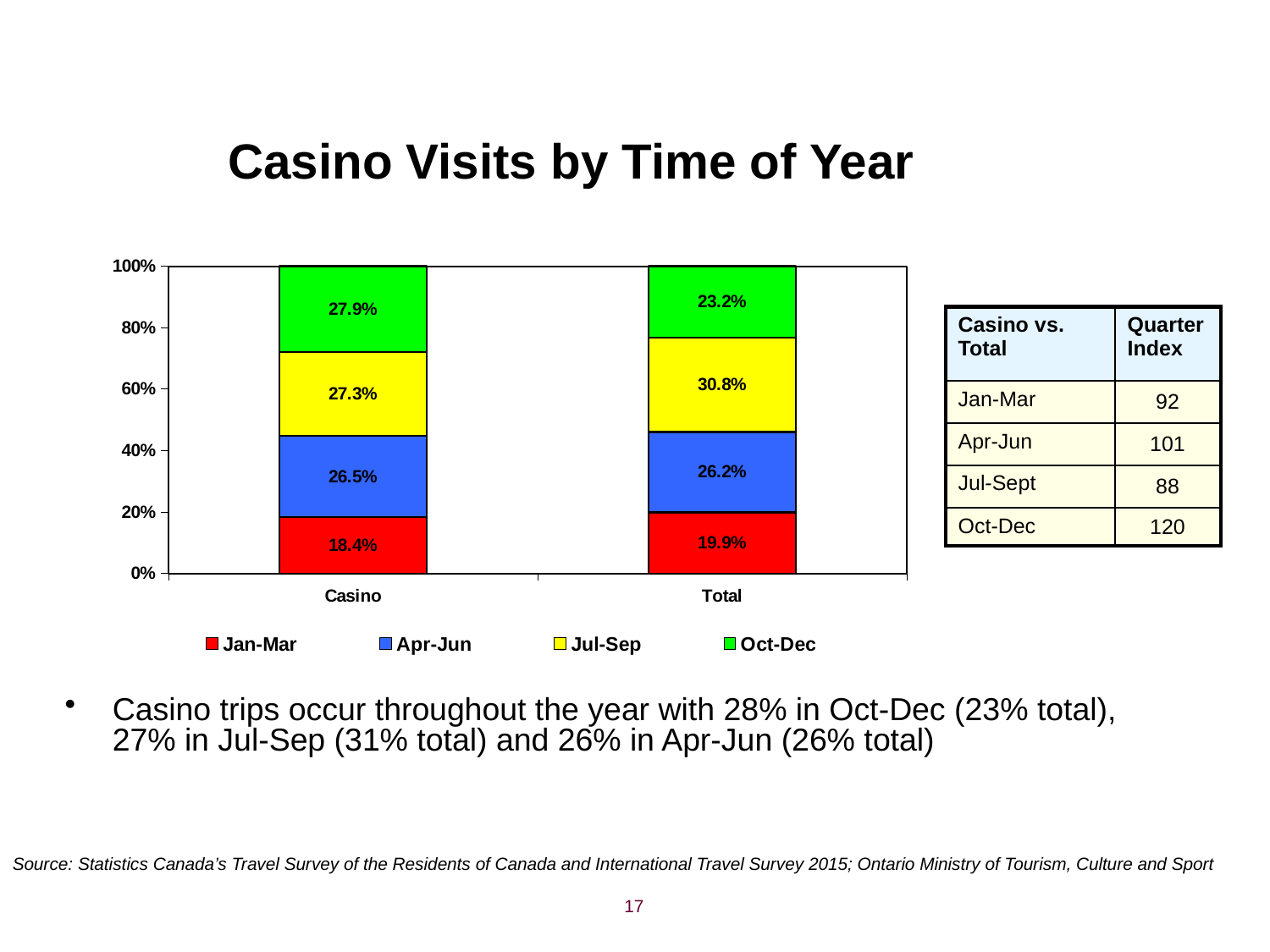
What kind of chart is shown on the slide? Stacked bar chart How many categories are shown on the x axis? 2 Which is larger, the Jul-Sep value for Casino or for Total? Total How many series does the legend list? 4 Which quarter has the largest share in the Casino bar? Oct-Dec What is the difference between the Oct-Dec values for Casino and Total? 4.7% What is the Oct-Dec value for the Casino bar? 27.9% What is the Apr-Jun value for the Total bar? 26.2% What is the Jul-Sep value for the Total bar? 30.8% What is the Jan-Mar value for the Casino bar? 18.4% What colour represents Jan-Mar in the chart? Red Which quarter has the smallest share in the Total bar? Jan-Mar